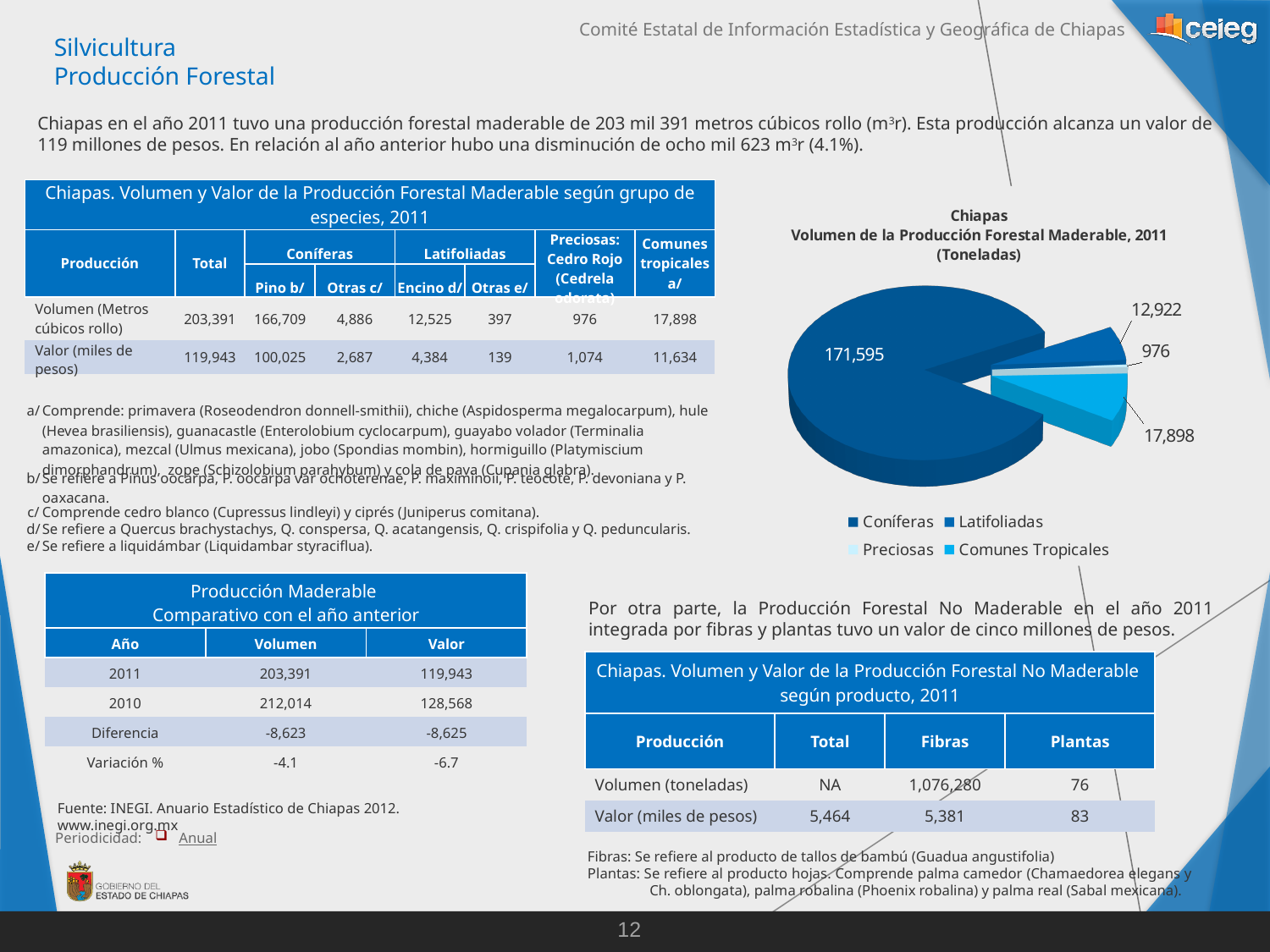
Which category has the smallest slice in the pie chart? Preciosas What unit is given in parentheses in the pie chart's title? Toneladas What is the value for Comunes Tropicales in the pie chart? 17,898 What is the value for Preciosas in the pie chart? 976 How many entries does the pie chart's legend list? 4 How many slices does the pie chart have? 4 Which is larger in the pie chart, Latifoliadas or Comunes Tropicales? Comunes Tropicales What is the value for Coníferas in the pie chart? 171,595 Which category has the largest slice in the pie chart? Coníferas What is the difference between the values for Comunes Tropicales and Latifoliadas in the pie chart? 4,976 What type of chart is shown on the slide? pie chart What is the value for Latifoliadas in the pie chart? 12,922